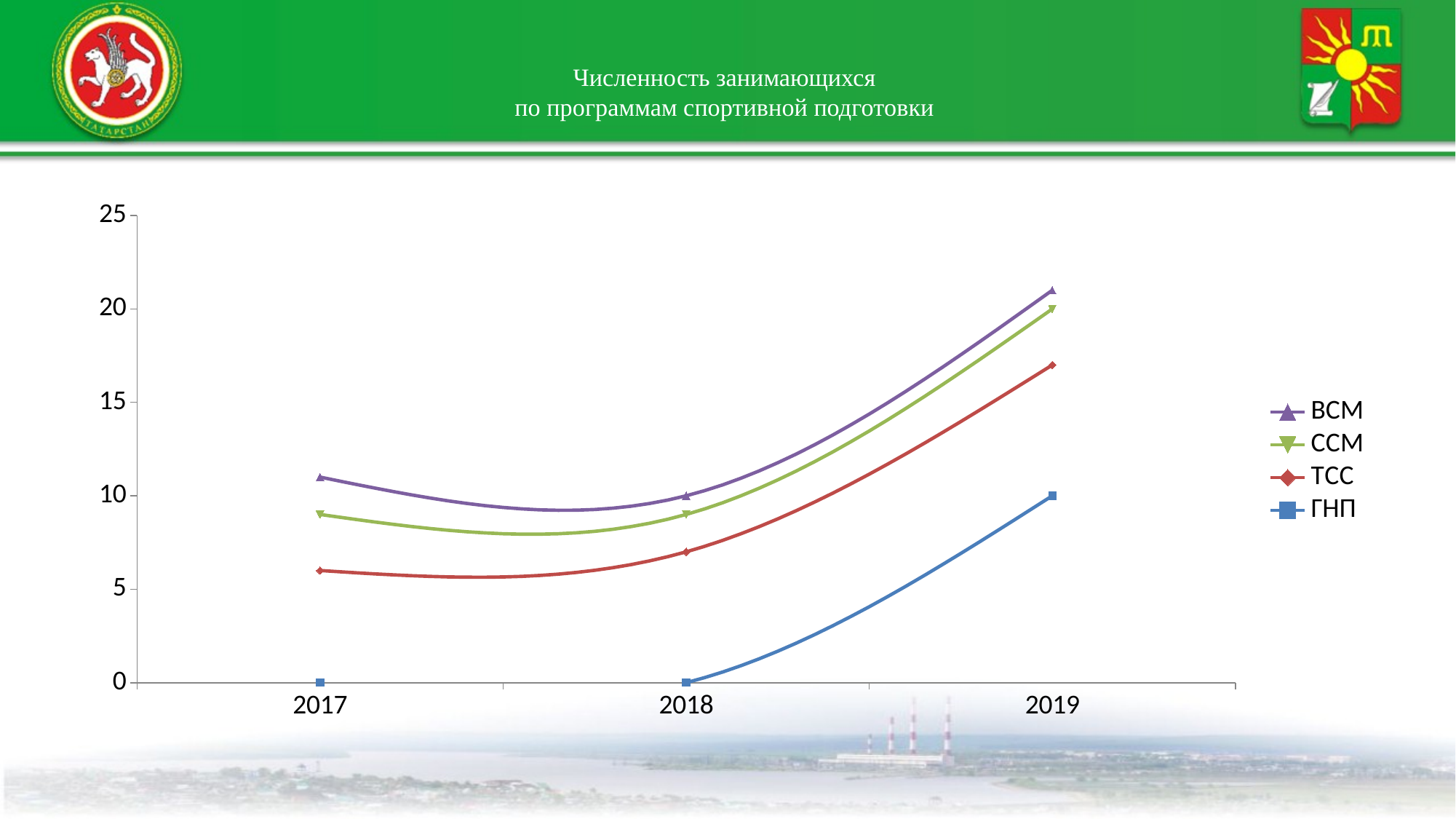
Which series has the lowest value in 2018? ГНП What kind of chart is shown on the slide? line chart Is the value for ТСС in 2019 greater or less than 15? greater Which is larger in 2017, ВСМ or ТСС? ВСМ What is the value for ССМ in 2019? 20 What is the value for ГНП in 2017? 0 Does the ГНП series rise or fall from 2018 to 2019? rise How many series does the legend list? 4 What is the value for ВСМ in 2018? 10 Which series has the highest value in 2019? ВСМ How many years are shown on the x axis? 3 What is the value for ГНП in 2019? 10